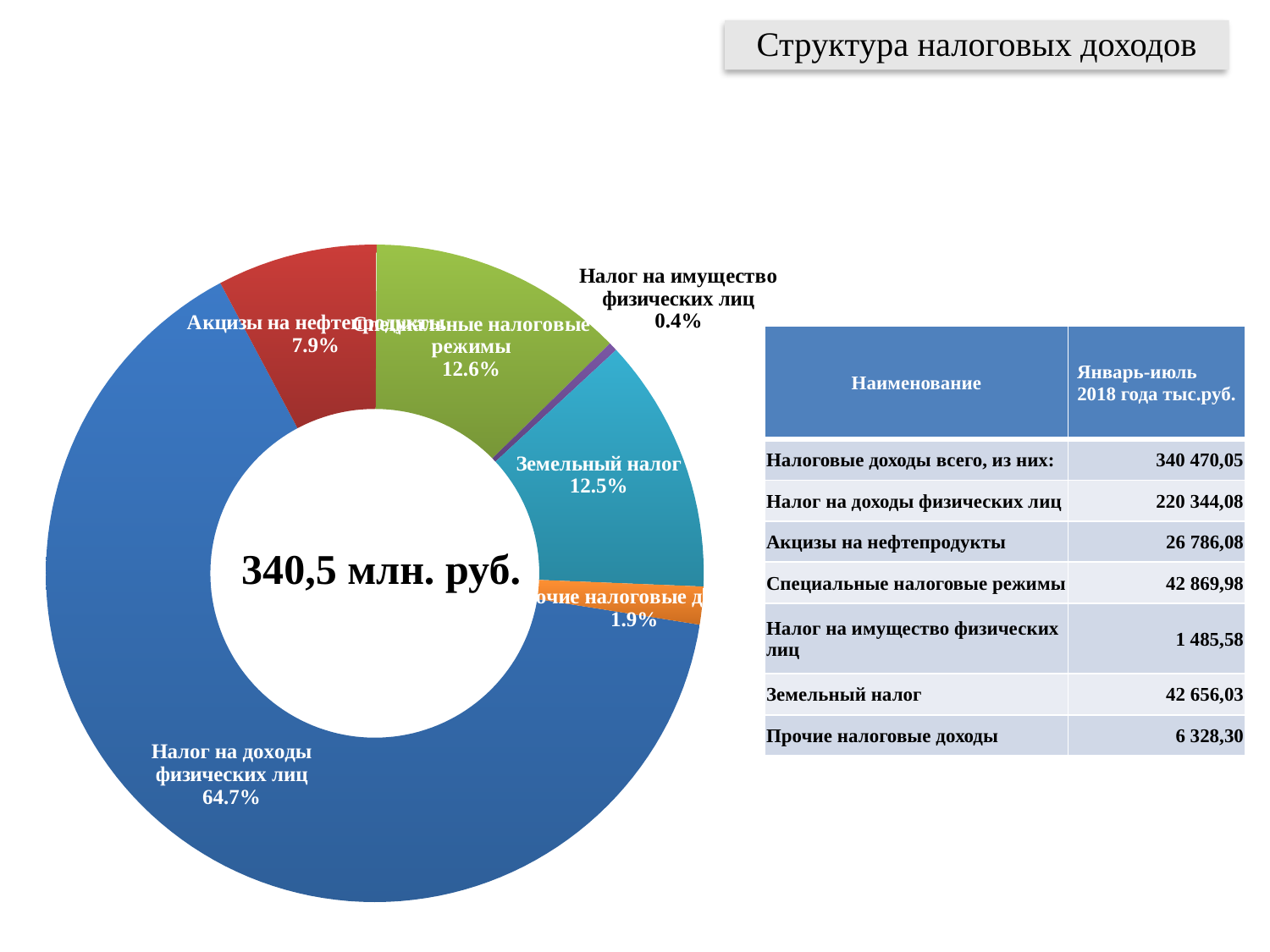
Which has a larger share: Специальные налоговые режимы or Акцизы на нефтепродукты? Специальные налоговые режимы How many categories are shown in the chart? 6 What type of chart is shown on the slide? Doughnut (pie) chart What percentage is shown for Акцизы на нефтепродукты in the chart? 7.9% What percentage is shown for Специальные налоговые режимы in the chart? 12.6% By how many percentage points does the share of Налог на доходы физических лиц exceed that of Акцизы на нефтепродукты? 56.8 What percentage is shown for Земельный налог in the chart? 12.5% What share of the doughnut chart does Налог на доходы физических лиц represent? 64.7% Which category has the smallest share in the chart? Налог на имущество физических лиц What total value is printed in the centre of the doughnut chart? 340,5 млн. руб. Which category has the largest share in the chart? Налог на доходы физических лиц What percentage is shown for Налог на имущество физических лиц in the chart? 0.4%